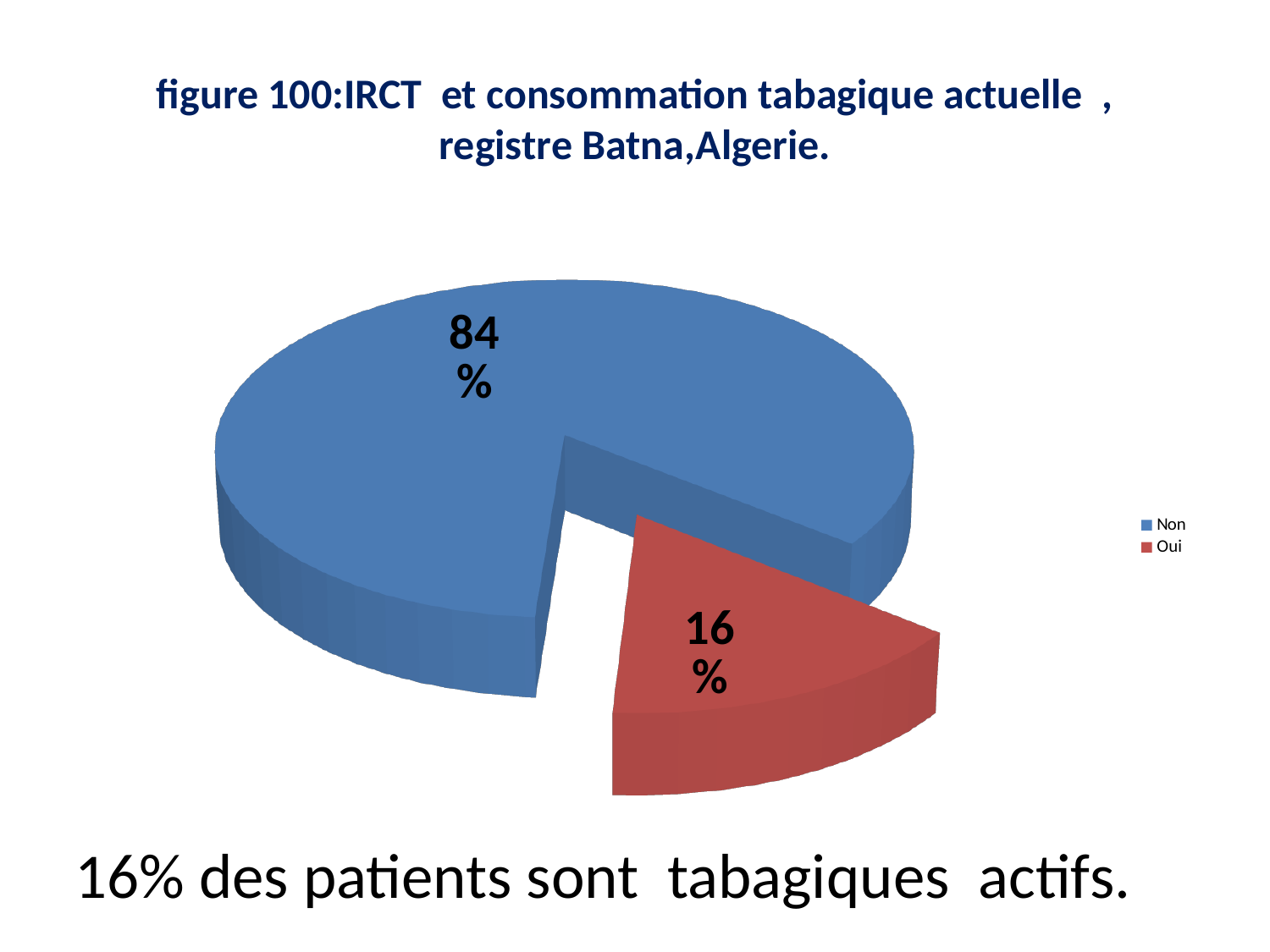
What is the title of the chart? figure 100:IRCT et consommation tabagique actuelle , registre Batna,Algerie. How many slices does the pie chart have? 2 What share of the pie does the "Non" slice represent? 84% Which category has the largest slice of the pie? Non What kind of chart is shown on the slide? Pie chart What colour is the "Oui" slice? Red What share of the pie does the "Oui" slice represent? 16% How many entries does the legend list? 2 Which slice is larger, "Non" or "Oui"? Non Which category has the smallest slice of the pie? Oui What is the difference in percentage points between the "Non" and "Oui" slices? 68